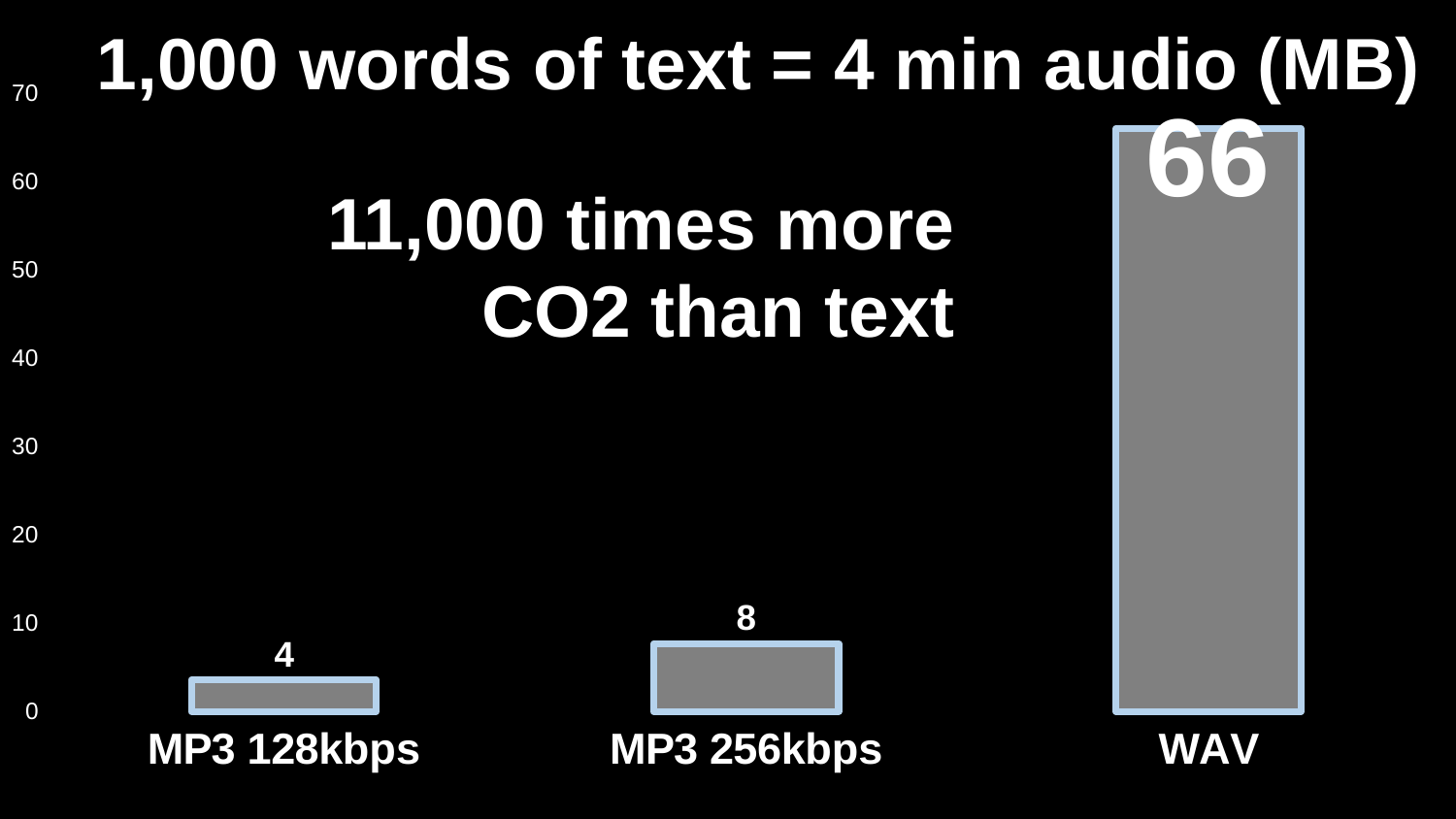
How many categories are shown on the chart? 3 What is the value for MP3 128kbps? 4 Which category has the lowest value? MP3 128kbps Which category has the highest value? WAV What is the difference between the values for MP3 256kbps and MP3 128kbps? 4 Is the value for WAV greater or less than 60? greater What is the value for WAV? 66 Which is larger, the value for MP3 256kbps or the value for MP3 128kbps? MP3 256kbps What is the difference between the values for WAV and MP3 256kbps? 58 What is the value for MP3 256kbps? 8 What kind of chart is shown on the slide? bar chart What is the title of the chart? 1,000 words of text = 4 min audio (MB)